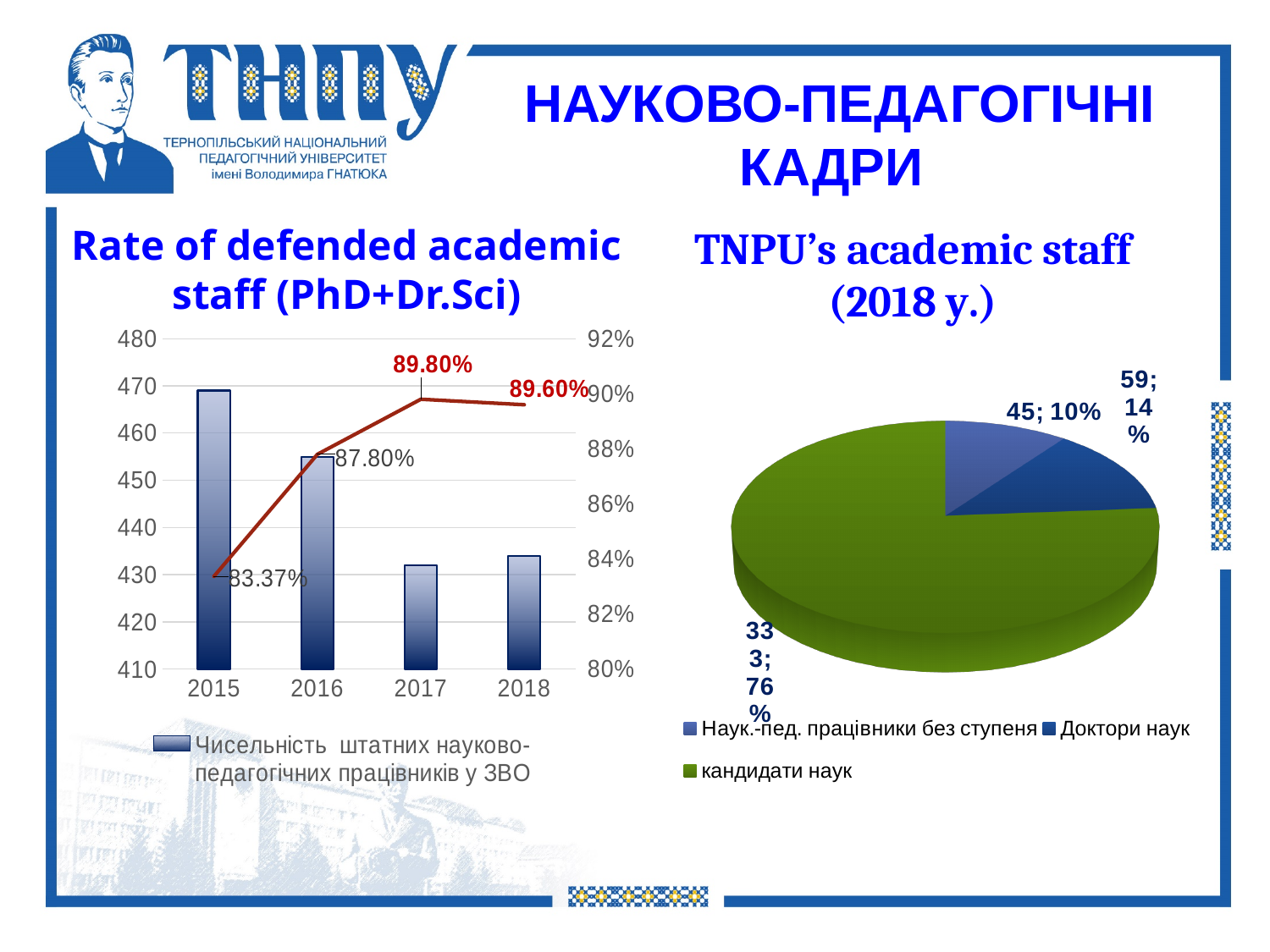
In the 'Rate of defended academic staff (PhD+Dr.Sci)' chart, is the bar value for 2017 greater or less than 440? less In the 'Rate of defended academic staff (PhD+Dr.Sci)' chart, which year has the highest percentage on the line? 2017 In the 'Rate of defended academic staff (PhD+Dr.Sci)' chart, which year has the lowest percentage on the line? 2015 In the 'TNPU's academic staff (2018 y.)' pie chart, which category has the largest slice? кандидати наук How many entries does the legend of the 'TNPU's academic staff (2018 y.)' pie chart list? 3 In the 'Rate of defended academic staff (PhD+Dr.Sci)' chart, how many years are shown on the x axis? 4 In the 'Rate of defended academic staff (PhD+Dr.Sci)' chart, by how much does the percentage for 2017 exceed that for 2016? 2.00% In the 'Rate of defended academic staff (PhD+Dr.Sci)' chart, does the percentage line rise or fall from 2015 to 2017? rise In the 'Rate of defended academic staff (PhD+Dr.Sci)' chart, what percentage is shown for 2015? 83.37% In the 'Rate of defended academic staff (PhD+Dr.Sci)' chart, is the bar value for 2015 greater or less than 460? greater In the 'TNPU's academic staff (2018 y.)' pie chart, what value and share are shown for Доктори наук? 59; 14% In the 'Rate of defended academic staff (PhD+Dr.Sci)' chart, what percentage is shown for 2017? 89.80%